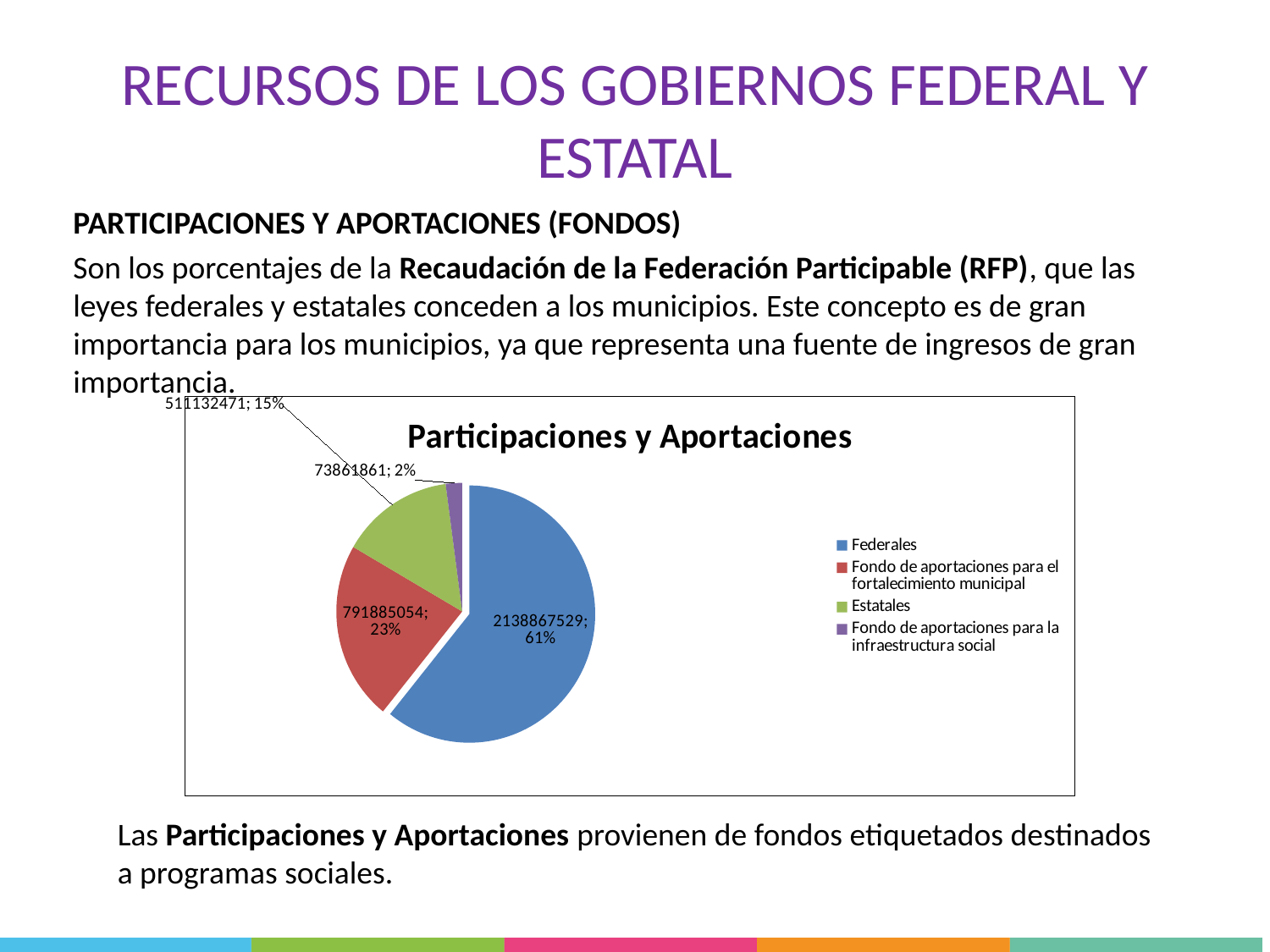
Which category has the largest slice of the pie? Federales What is the title of the chart? Participaciones y Aportaciones What value is shown for Federales? 2138867529 What percentage share does Fondo de aportaciones para la infraestructura social have? 2% What value is shown for Fondo de aportaciones para el fortalecimiento municipal? 791885054 How many entries does the legend list? 4 What kind of chart is shown on the slide? pie chart Which is larger, the value for Estatales or the value for Fondo de aportaciones para el fortalecimiento municipal? Fondo de aportaciones para el fortalecimiento municipal What percentage share does Federales have in the pie chart? 61% What percentage share does Estatales have in the pie chart? 15% Which category has the smallest slice of the pie? Fondo de aportaciones para la infraestructura social How many slices does the pie chart have? 4